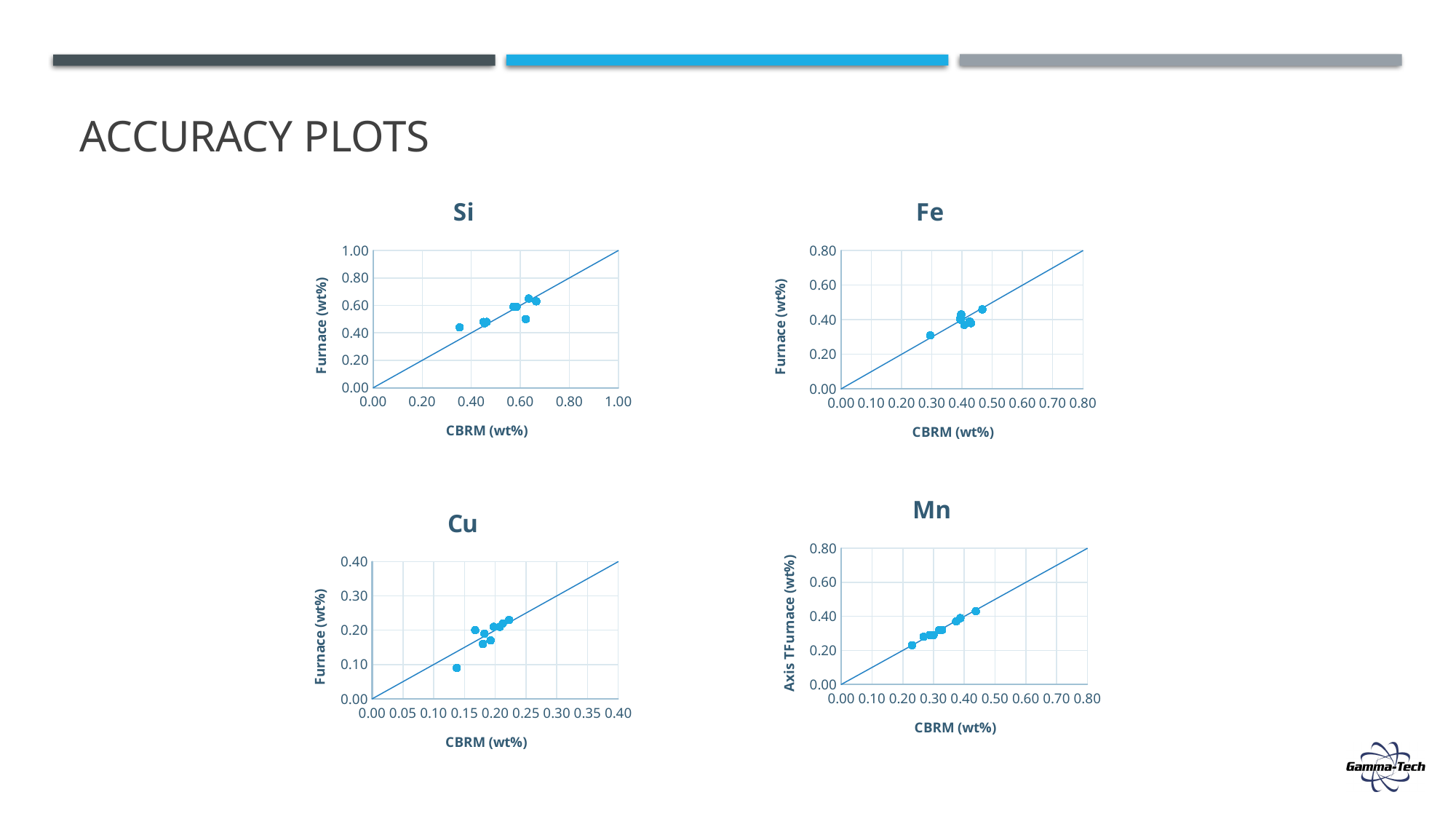
How many charts are shown on the slide? 4 In the Fe chart, what is the maximum value shown on the y axis? 0.80 What is the x-axis title of the Cu chart? CBRM (wt%) In the Mn chart, is the Furnace value of the highest point greater or less than 0.60? less In the Mn chart, do the Furnace values rise or fall as the CBRM values increase? rise In the Si chart, what is the maximum value shown on the y axis? 1.00 In the Si chart, is the Furnace value of the leftmost point greater or less than 0.40? greater What is the y-axis title of the Mn chart? Axis TFurnace (wt%) What kind of chart is the Si chart? scatter chart In the Cu chart, what is the maximum value shown on the x axis? 0.40 In the Fe chart, is the Furnace value of the leftmost point greater or less than 0.20? greater